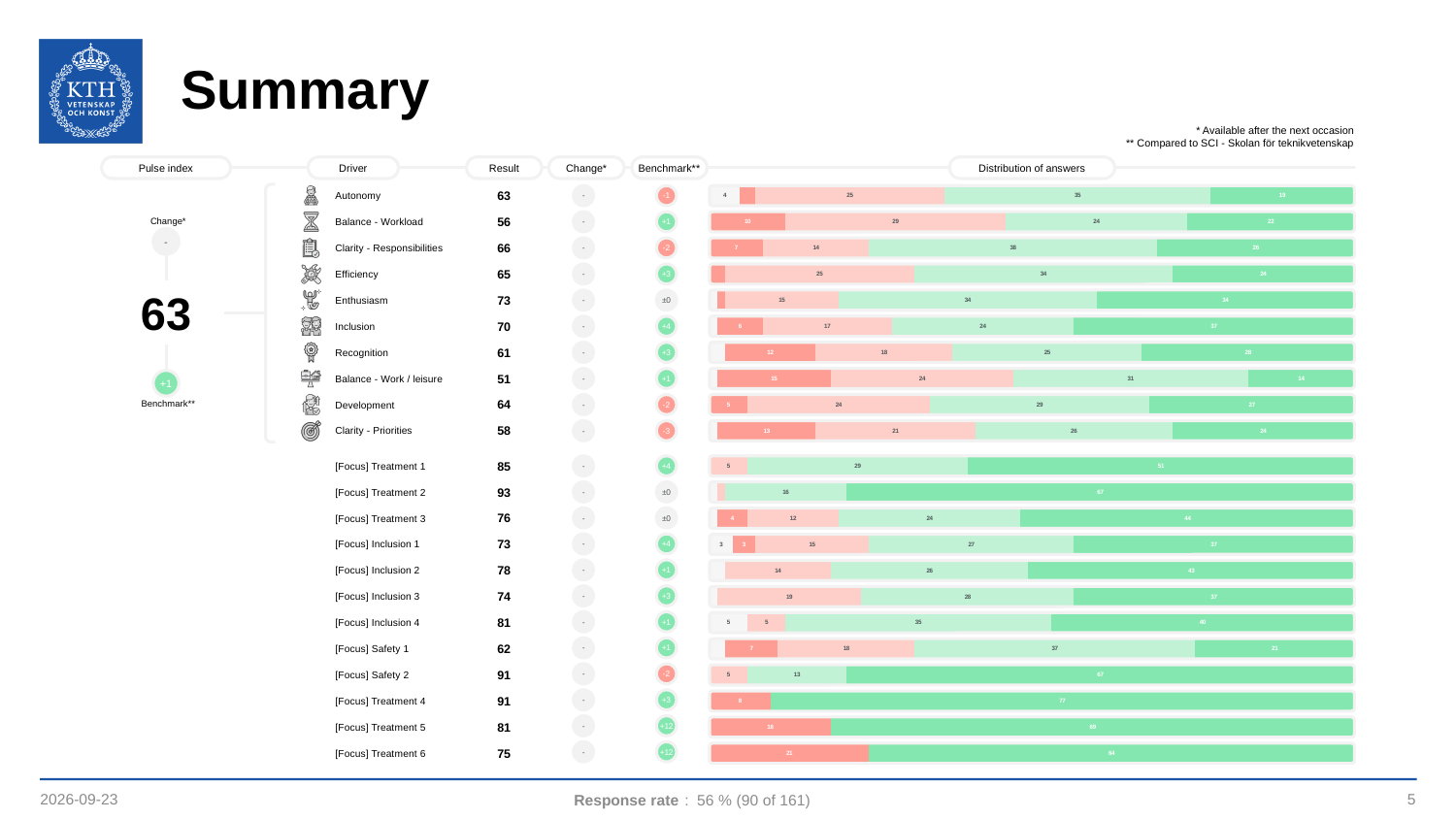
Which driver has the highest Result? [Focus] Treatment 2 What is the Result for Autonomy? 63 What is the Result for [Focus] Treatment 2? 93 What is the Benchmark value shown for [Focus] Treatment 5? +12 How many drivers are listed in the table? 22 What is the Response rate shown at the bottom of the slide? 56 % (90 of 161) Which has a higher Result, Enthusiasm or Inclusion? Enthusiasm What kind of chart is used to show the Distribution of answers? Stacked bar chart What is the Result for Balance - Work / leisure? 51 Which driver has the lowest Result? Balance - Work / leisure What is the overall Pulse index shown on the slide? 63 What is the difference between the Result for [Focus] Treatment 2 and the Result for Balance - Work / leisure? 42